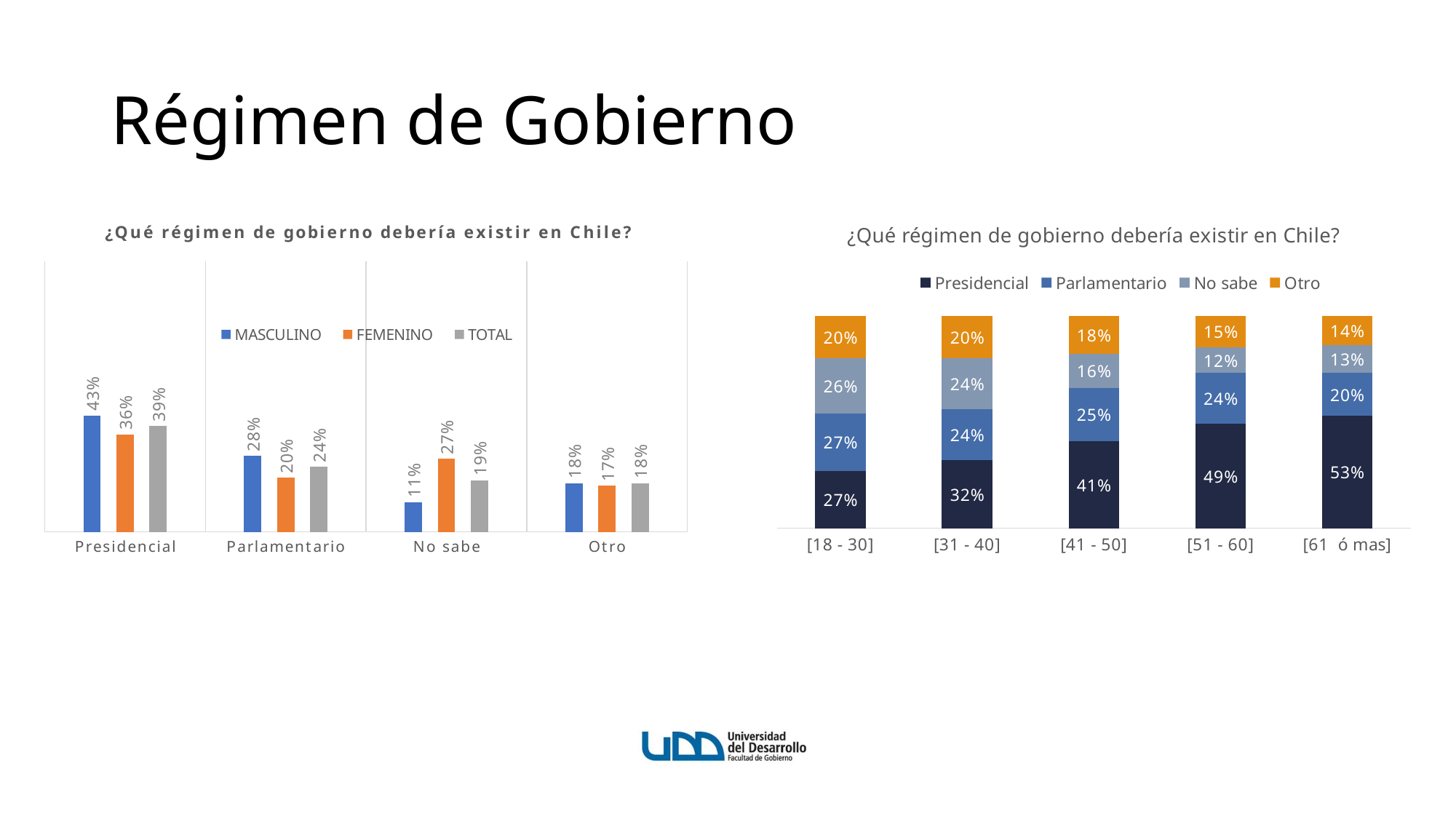
In the right chart, what is the Otro share for the [41 - 50] age group? 18% In the left chart, what is the FEMENINO value for No sabe? 27% In the left chart, what is the difference between the MASCULINO and FEMENINO values for Parlamentario? 8% In the right chart, does the Presidencial share rise or fall as the age groups increase from [18 - 30] to [61 ó mas]? rise In the left chart, which category has the highest TOTAL value? Presidencial In the left chart, which category has the lowest MASCULINO value? No sabe What kind of chart is the right chart? stacked bar chart In the right chart, which age group has the highest Presidencial share? [61 ó mas] In the right chart, what is the Presidencial share for the [61 ó mas] age group? 53% In the left chart, how many series does the legend list? 3 In the right chart, how many age groups are shown on the x axis? 5 In the left chart, what is the MASCULINO value for Presidencial? 43%